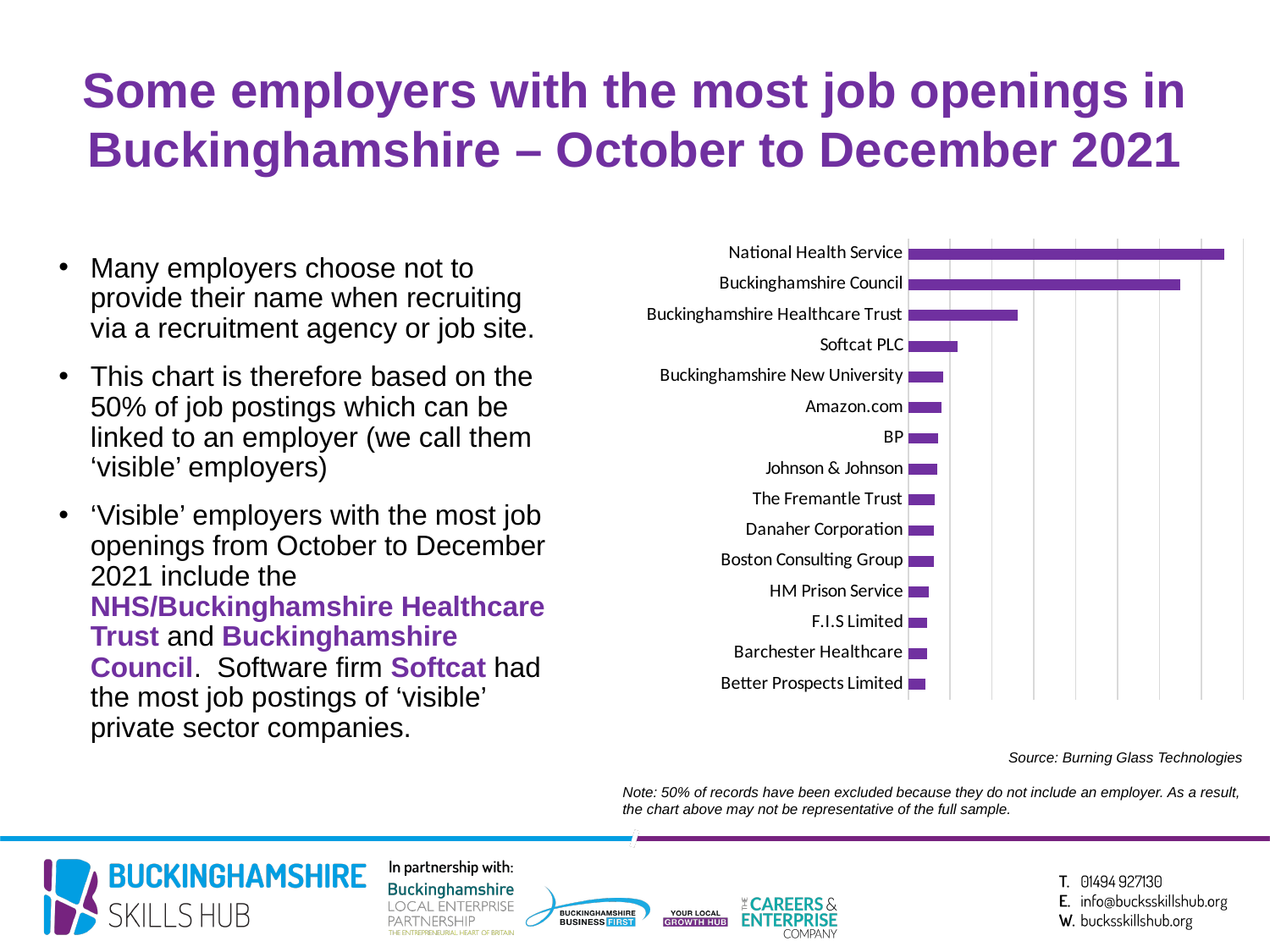
Do the bar lengths increase or decrease going from the top of the chart to the bottom? Decrease Which employer has the shortest bar in the chart? Better Prospects Limited Which employer is listed directly below Softcat PLC in the chart? Buckinghamshire New University Which has the longer bar, Softcat PLC or Amazon.com? Softcat PLC What colour are the bars in the chart? Purple Which has the longer bar, Buckinghamshire Council or Buckinghamshire New University? Buckinghamshire Council Which has the longer bar, National Health Service or Buckinghamshire Council? National Health Service What kind of chart is shown on the slide? Bar chart Which employer has the longest bar in the chart? National Health Service How many employers are listed in the chart? 15 Are the bars in the chart horizontal or vertical? Horizontal